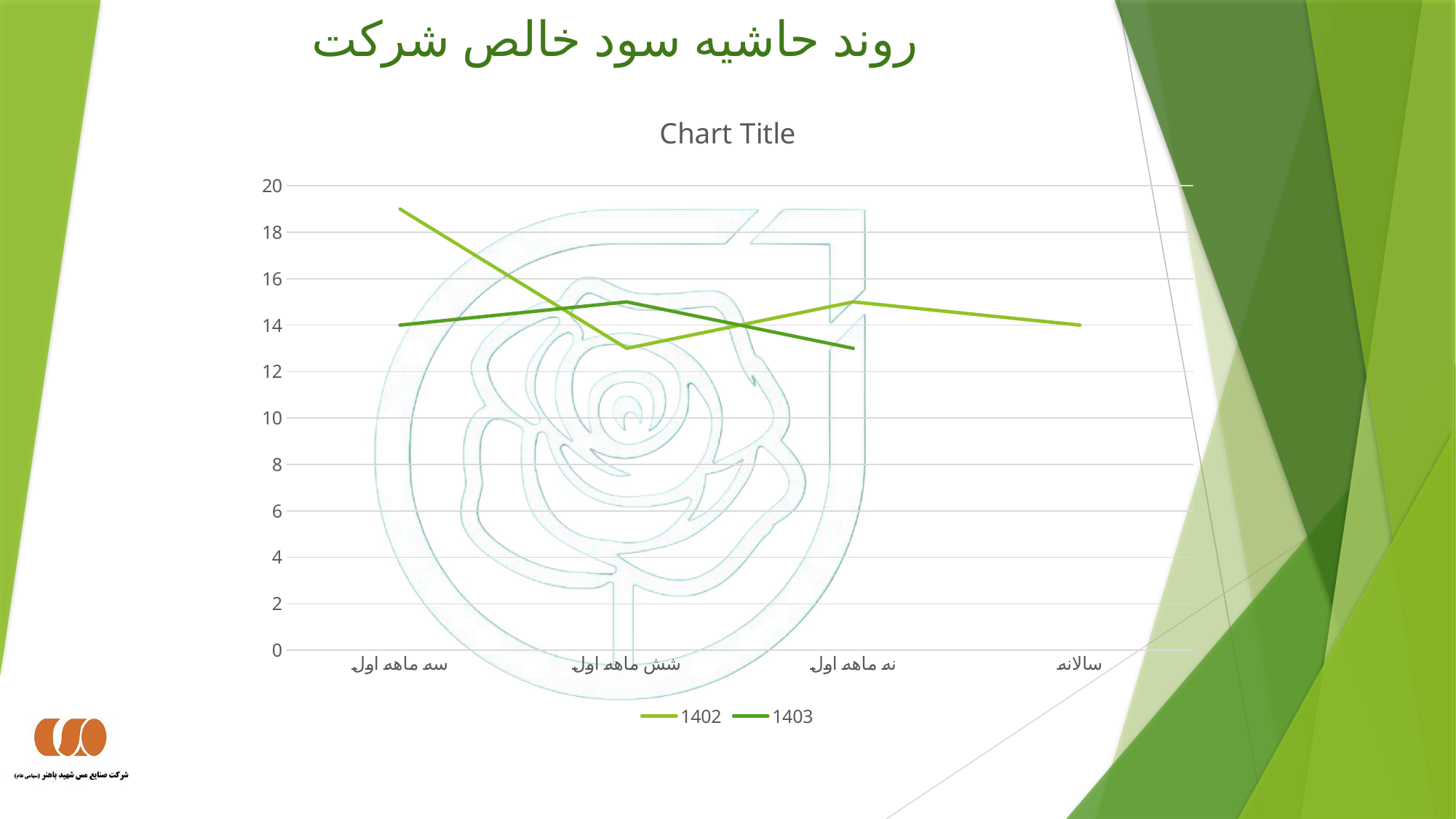
What kind of chart is shown on the slide? line chart How many series does the legend list? 2 How many categories are on the x axis? 4 What is the title printed above the chart? Chart Title Is the value of the 1402 series at شش ماهه اول greater or less than 14? less For the 1402 series, which category has the highest value? سه ماهه اول Does the 1402 series rise or fall from سه ماهه اول to شش ماهه اول? fall Is the value of the 1402 series at سه ماهه اول greater or less than 18? greater Is the value of the 1403 series at نه ماهه اول greater or less than 14? less For the 1402 series, which category has the lowest value? شش ماهه اول At سه ماهه اول, which series has the larger value, 1402 or 1403? 1402 Which series are listed in the legend? 1402 and 1403